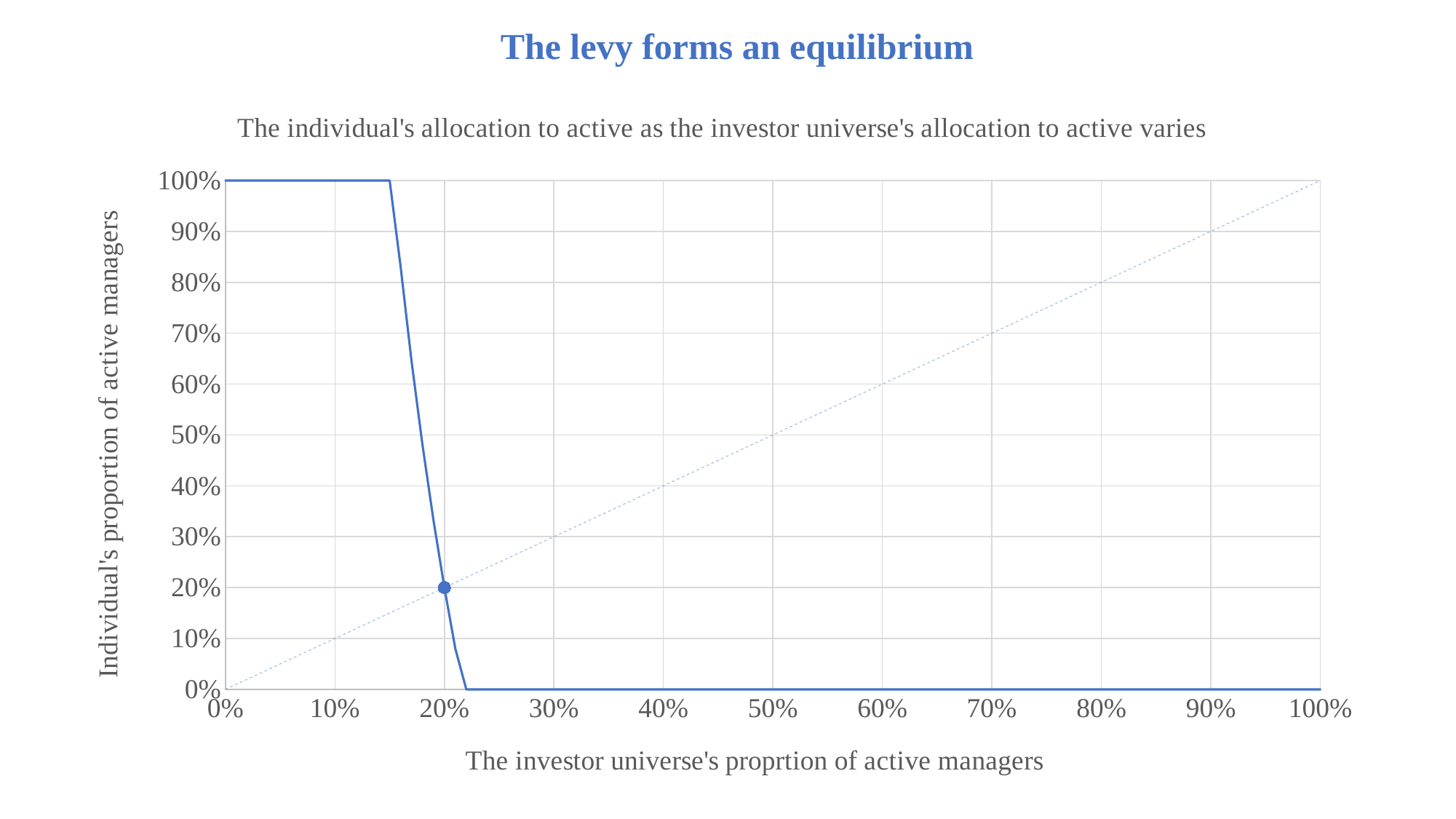
What is the individual's proportion of active managers when the investor universe's proportion is 90%? 0% What is the individual's proportion of active managers when the investor universe's proportion is 0%? 100% What is the individual's proportion of active managers when the investor universe's proportion is 50%? 0% What is the title of the chart? The individual's allocation to active as the investor universe's allocation to active varies Is the individual's proportion of active managers at an investor universe proportion of 5% greater or less than 50%? greater What is the individual's proportion of active managers at the highlighted point, where the investor universe's proportion is 20%? 20% What is the individual's proportion of active managers when the investor universe's proportion is 10%? 100% What is the label of the y axis? Individual's proportion of active managers Is the individual's proportion of active managers at an investor universe proportion of 30% greater or less than 50%? less What kind of chart is shown on the slide? line chart Which is larger: the individual's proportion of active managers at an investor universe proportion of 10% or at 40%? 10% Does the individual's proportion of active managers rise or fall as the investor universe's proportion increases from 10% to 30%? fall